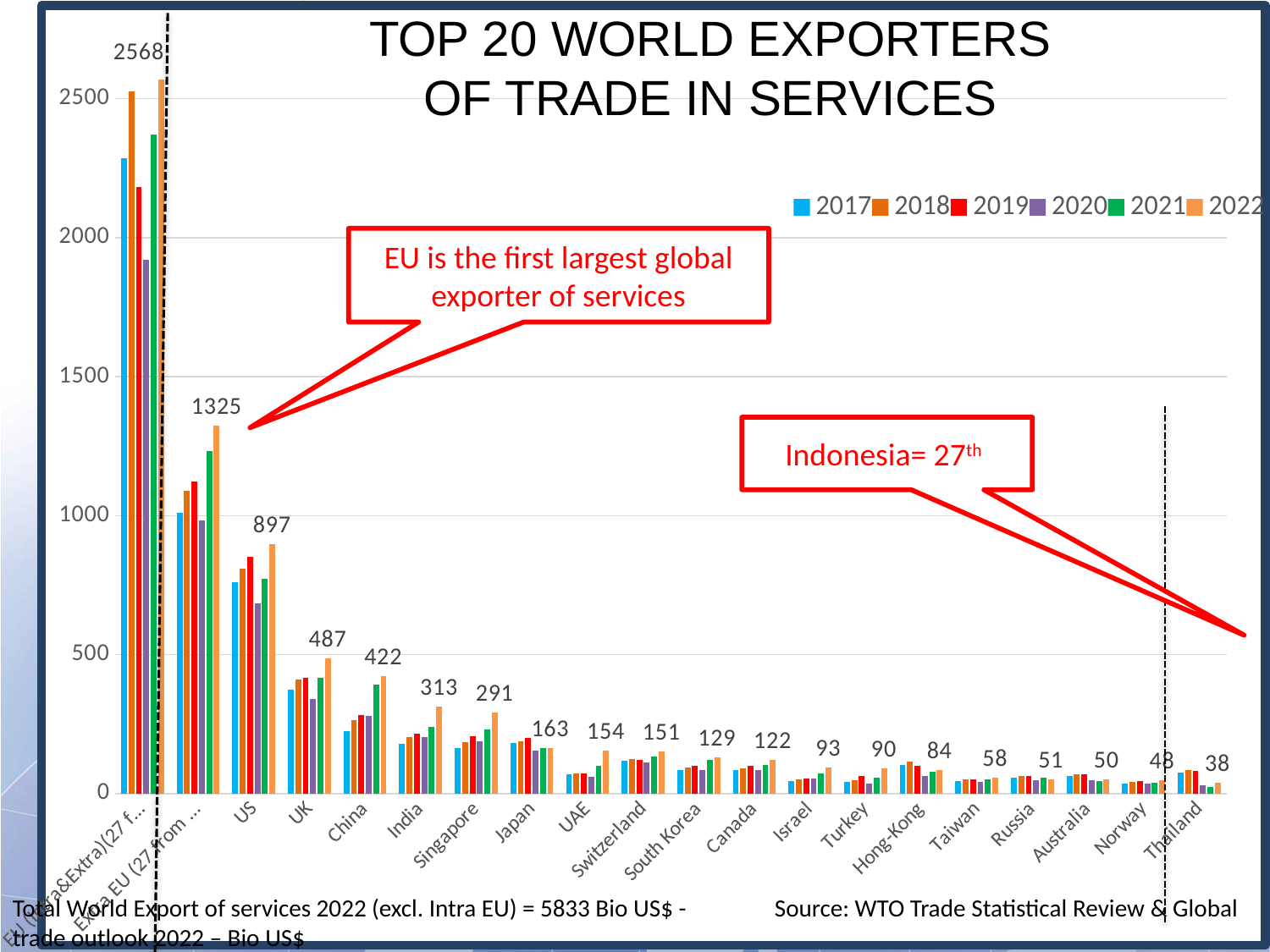
What is the labelled 2022 value for the UK? 487 What is the labelled 2022 value for Thailand? 38 Which has the larger labelled 2022 value, Singapore or Japan? Singapore What is the labelled 2022 value for Japan? 163 How many series does the legend list? 6 What is the title of the chart? TOP 20 WORLD EXPORTERS OF TRADE IN SERVICES How many countries or regions are shown along the x axis? 20 What kind of chart is shown on the slide? bar chart What is the labelled 2022 value for the US? 897 Which of the 20 exporters has the lowest labelled 2022 value? Thailand Is the 2017 value for the US greater or less than 1000? less What is the difference between the labelled 2022 values for the US and the UK? 410